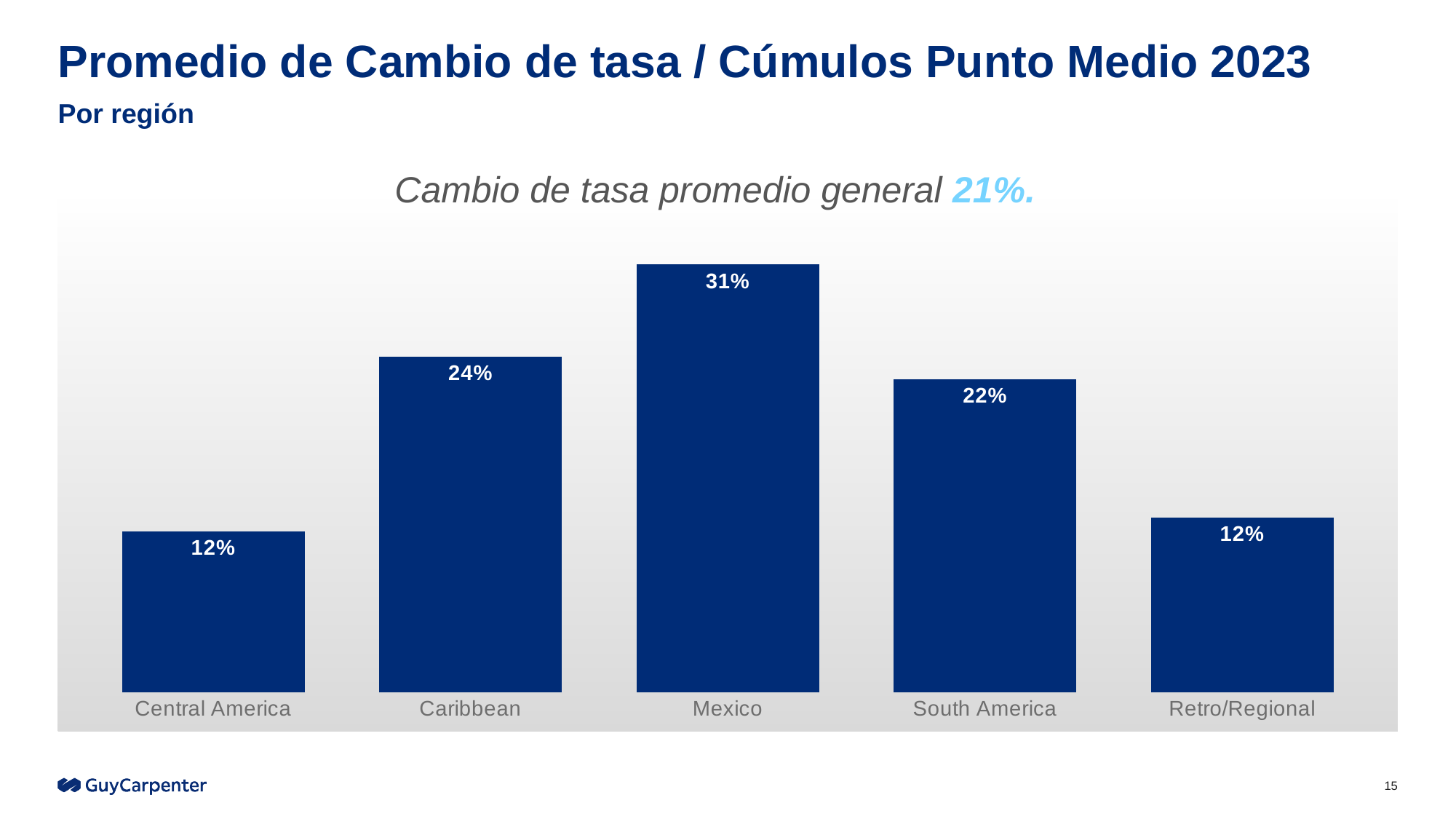
What is the difference between the values for Mexico and Caribbean? 7% Which is larger, the value for Caribbean or the value for South America? Caribbean What is the value for Central America? 12% Which two regions share the same value of 12%? Central America and Retro/Regional What is the value for Mexico? 31% What is the difference between the values for South America and Retro/Regional? 10% What overall average rate change is stated above the chart? 21% What kind of chart is shown on the slide? Bar chart Which region has the highest value? Mexico What is the value for South America? 22% How many regions are shown in the chart? 5 What is the value for Caribbean? 24%